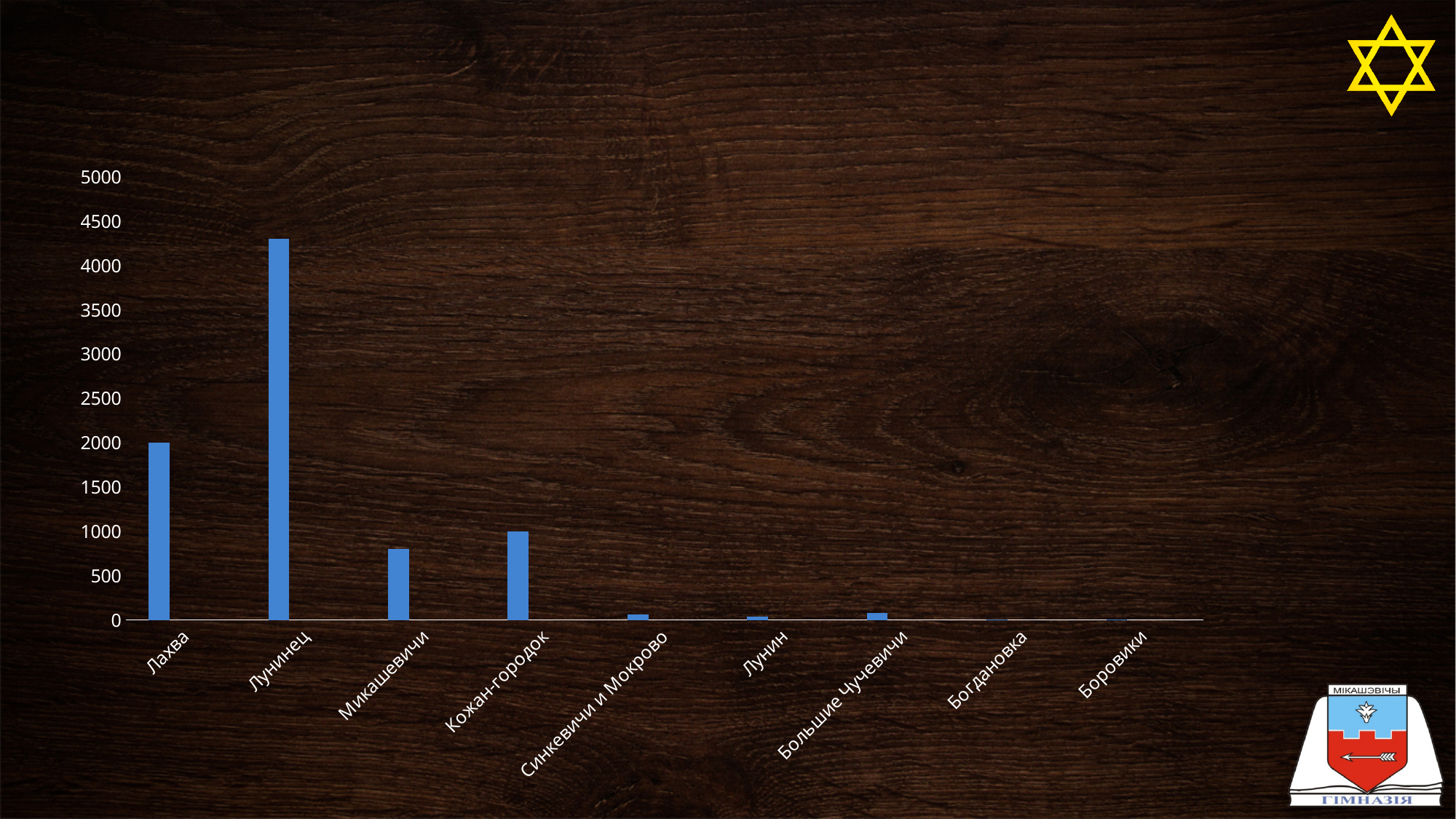
Which is larger, the value for Микашевичи or the value for Большие Чучевичи? Микашевичи Which category has the highest bar in the chart? Лунинец Which is larger, the value for Лахва or the value for Кожан-городок? Лахва Is the value for Микашевичи greater or less than 500? greater Is the value for Лунинец greater or less than 4500? less How many categories are shown on the x axis of the chart? 9 Is the value for Синкевичи и Мокрово greater or less than 500? less What is the highest value shown on the vertical axis of the chart? 5000 What kind of chart is shown on the slide? bar chart What colour are the bars in the chart? blue